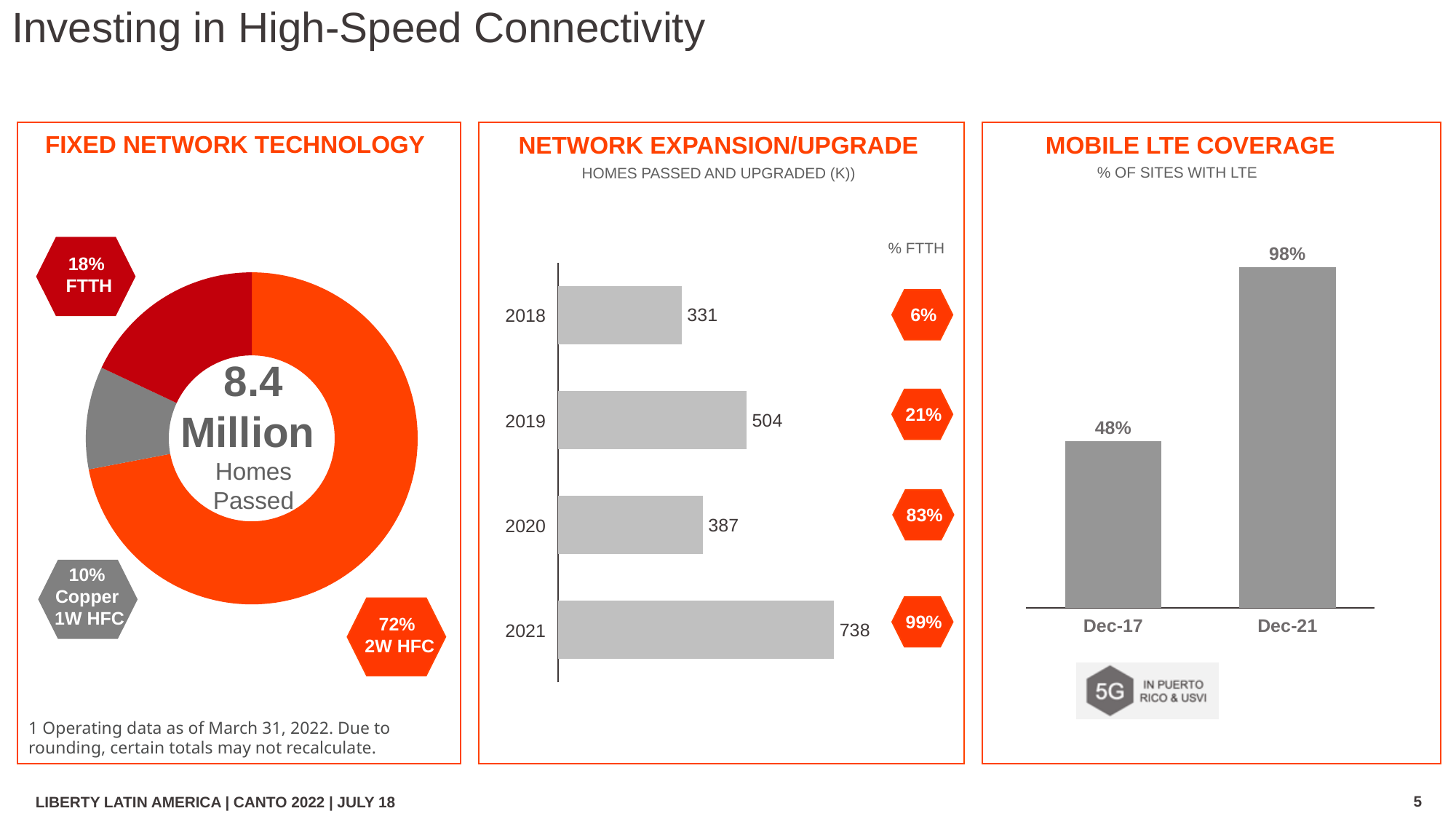
In the Network Expansion/Upgrade chart, what is the value for 2019? 504 In the Mobile LTE Coverage chart, what is the value for Dec-17? 48% In the Mobile LTE Coverage chart, do values rise or fall from Dec-17 to Dec-21? rise In the Fixed Network Technology chart, what total is shown in the centre of the donut? 8.4 Million Homes Passed In the Network Expansion/Upgrade chart, what is the difference between the 2021 and 2020 values? 351 In the Fixed Network Technology chart, what share of homes passed is 2W HFC? 72% In the Network Expansion/Upgrade chart, which year has the lowest homes passed and upgraded? 2018 In the Network Expansion/Upgrade chart, what is the % FTTH shown for 2020? 83% What kind of chart is the Fixed Network Technology chart? donut chart In the Network Expansion/Upgrade chart, how many years are shown? 4 In the Mobile LTE Coverage chart, what is the difference between Dec-21 and Dec-17? 50% In the Network Expansion/Upgrade chart, which year has the highest homes passed and upgraded? 2021